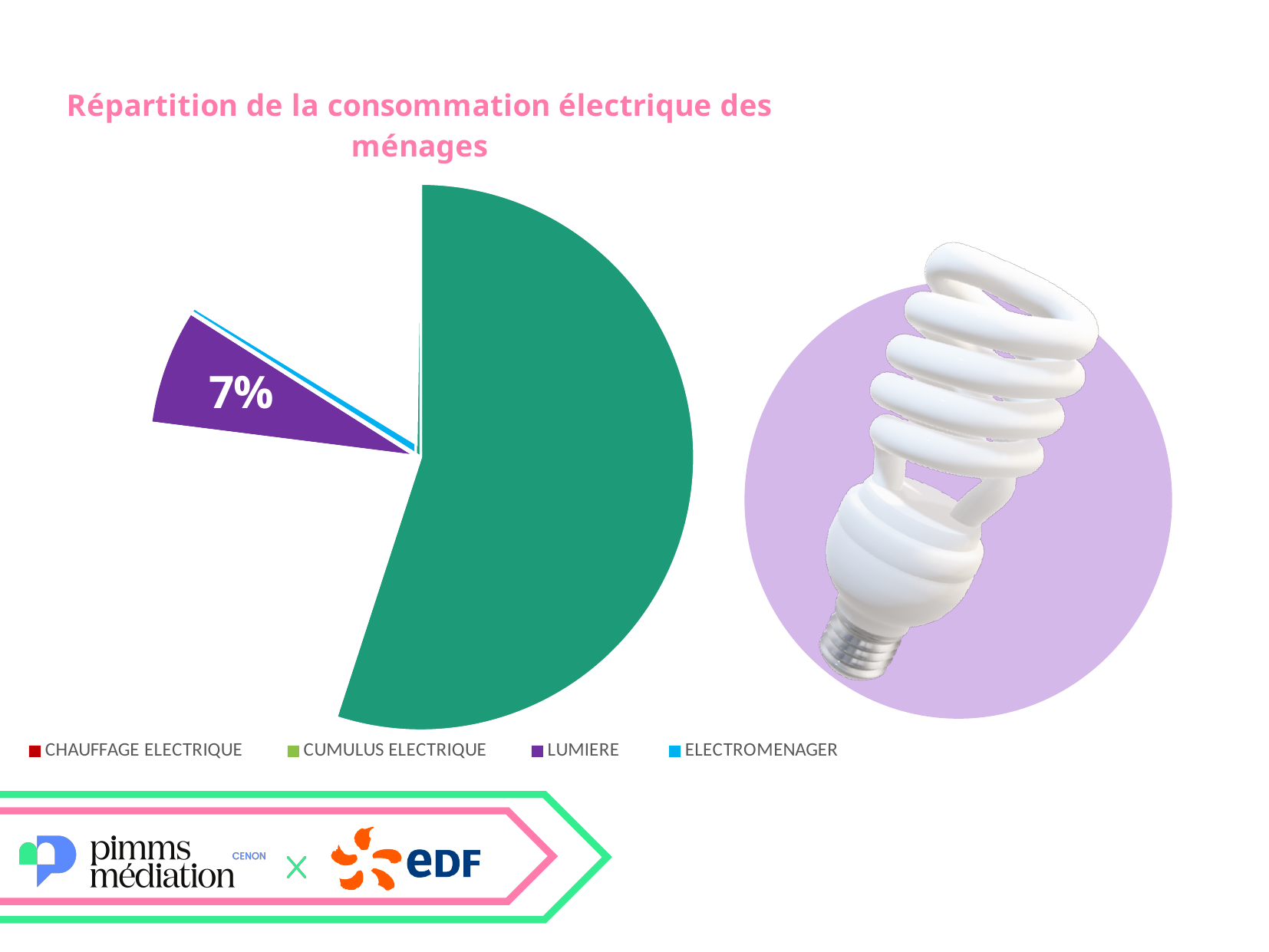
What kind of chart is shown on the slide? pie chart What is the title of the chart? Répartition de la consommation électrique des ménages What share of household electricity consumption does the LUMIERE slice represent? 7% How many categories does the chart legend list? 4 Which legend entry is shown in blue? ELECTROMENAGER Is the share for LUMIERE greater or less than 10%? less Which category is shown with the purple slice labelled 7%? LUMIERE